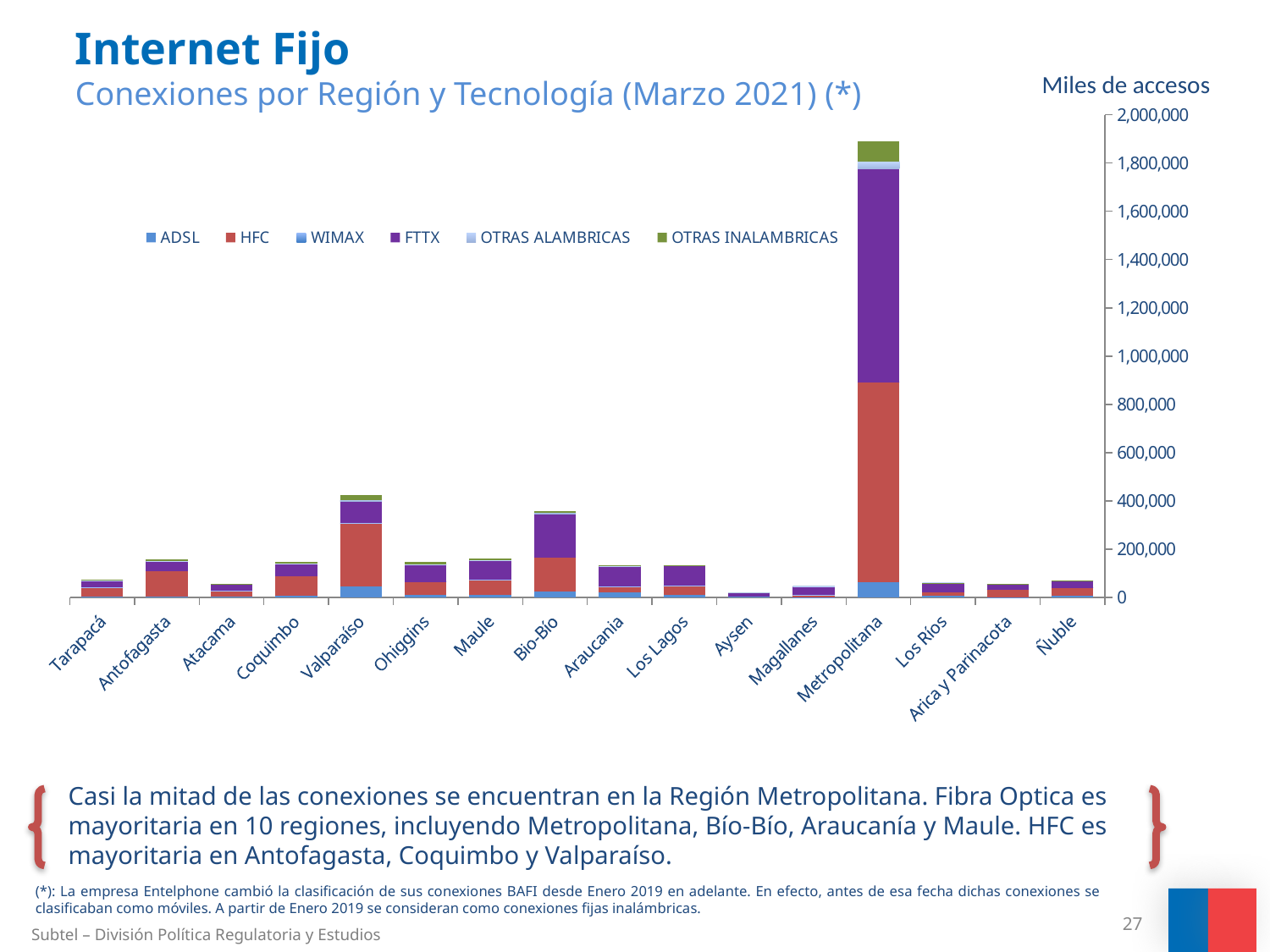
Which region has a larger total, Valparaíso or Bío-Bío? Valparaíso Which technology series is shown in red in the chart legend? HFC Which region has a larger total, Metropolitana or Valparaíso? Metropolitana Which region has the tallest stacked bar in the chart? Metropolitana Is the total value for Bío-Bío greater or less than 400,000? less How many series does the chart legend list? 6 Which region has the shortest stacked bar in the chart? Aysen Is the total value for Valparaíso greater or less than 200,000? greater What unit label is shown above the vertical axis of the chart? Miles de accesos Is the total value for Metropolitana greater or less than 1,800,000? greater What kind of chart is shown on the slide? Stacked bar chart How many regions are shown along the x axis of the chart? 16